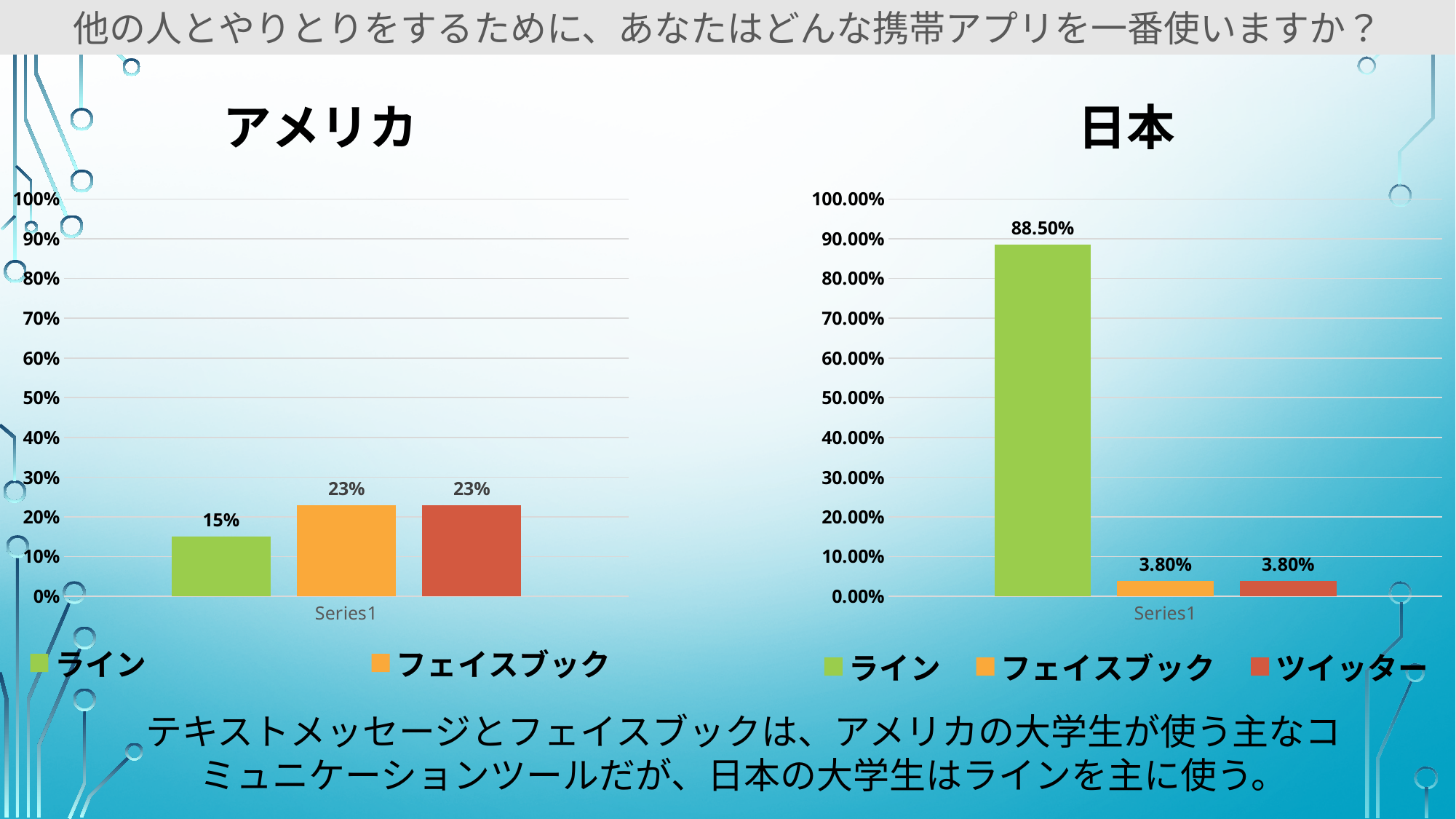
In the アメリカ chart, what is the value for ライン? 15% In the 日本 chart, what is the difference between ライン and フェイスブック? 84.70% In the 日本 chart, which series has the highest value? ライン How many series does the legend of the 日本 chart list? 3 In the アメリカ chart, what is the value for フェイスブック? 23% In the 日本 chart, what is the value for ツイッター? 3.80% How many bars are plotted in the アメリカ chart? 3 In the アメリカ chart, what is the difference between フェイスブック and ライン? 8% In the 日本 chart, is the value for ライン greater or less than 80.00%? greater What kind of chart is the 日本 chart? bar chart In the アメリカ chart, which is larger, ライン or フェイスブック? フェイスブック In the 日本 chart, what is the value for ライン? 88.50%